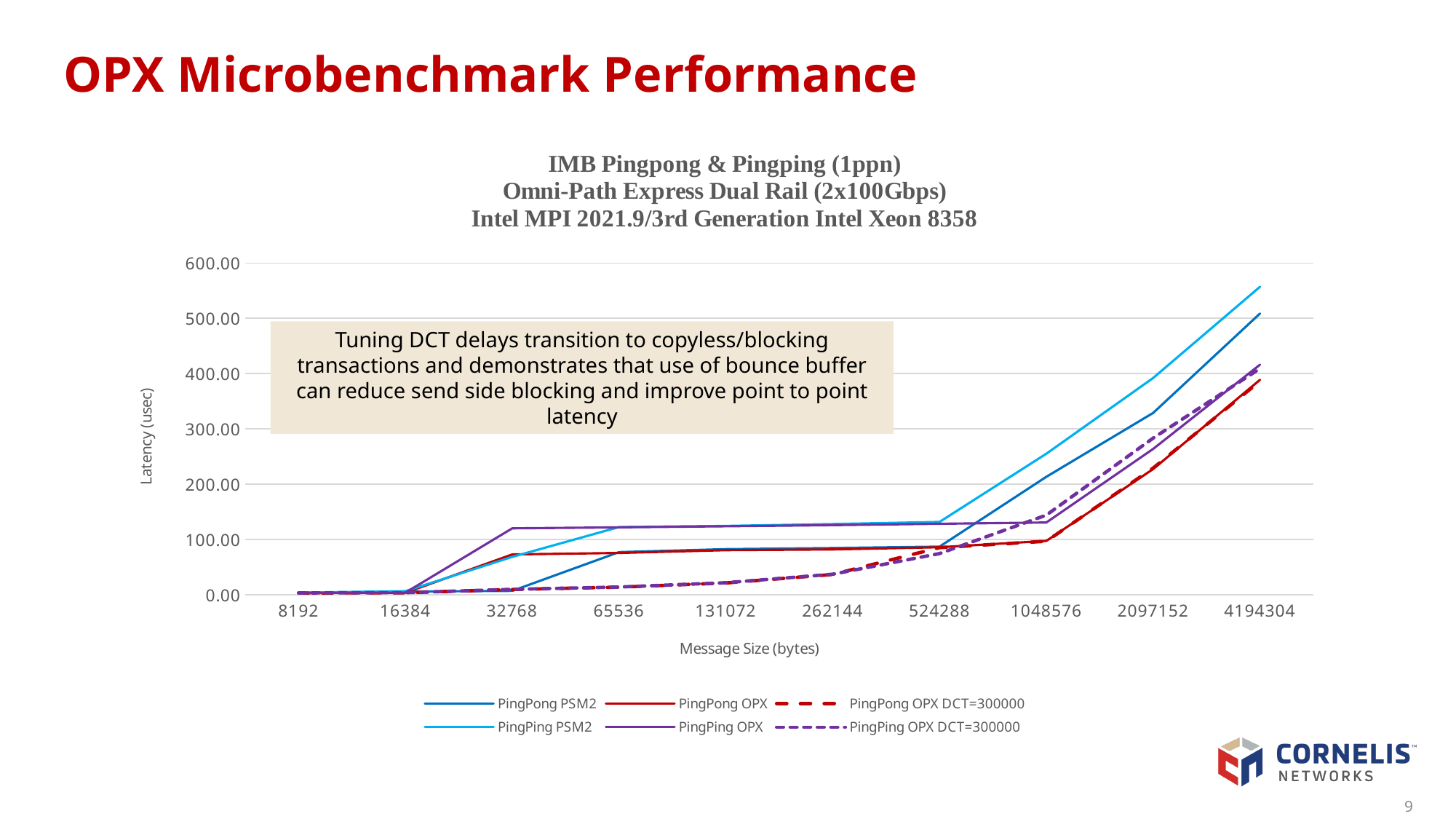
How many series does the legend list? 6 Does the latency for PingPing PSM2 rise or fall as message size increases along the x axis? rise At message size 4194304, which has the higher latency: PingPing PSM2 or PingPong PSM2? PingPing PSM2 What is the label of the y axis? Latency (usec) Is the latency for PingPing OPX at message size 65536 greater or less than 100.00? greater Is the latency for PingPong OPX at message size 4194304 greater or less than 500.00? less Which series has the highest latency at message size 4194304? PingPing PSM2 What kind of chart is shown on the slide? line chart Is the latency for PingPong PSM2 at message size 32768 greater or less than 100.00? less How many message sizes are shown on the x axis? 10 Which series has the highest latency at message size 32768? PingPing OPX